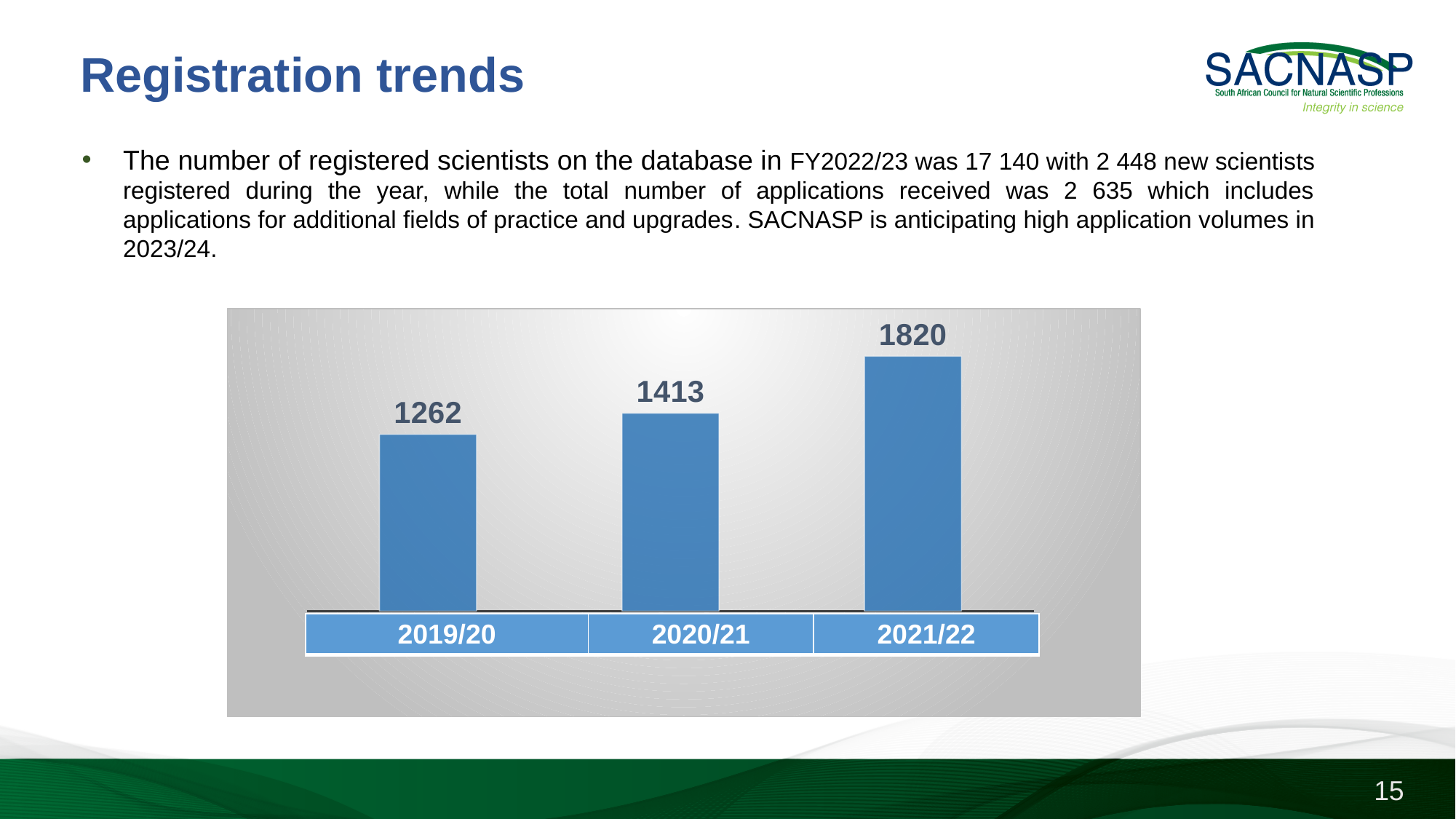
What is the difference between the values for 2020/21 and 2019/20? 151 What kind of chart is shown on the slide? Bar chart What is the difference between the values for 2021/22 and 2020/21? 407 What colour are the bars in the chart? Blue How many years are shown on the chart? 3 Which is larger, the value for 2019/20 or the value for 2021/22? 2021/22 Which year has the lowest value? 2019/20 What is the value for 2019/20? 1262 What is the value for 2020/21? 1413 Which year has the highest value? 2021/22 What is the value for 2021/22? 1820 Do the values rise or fall from 2019/20 to 2021/22? Rise